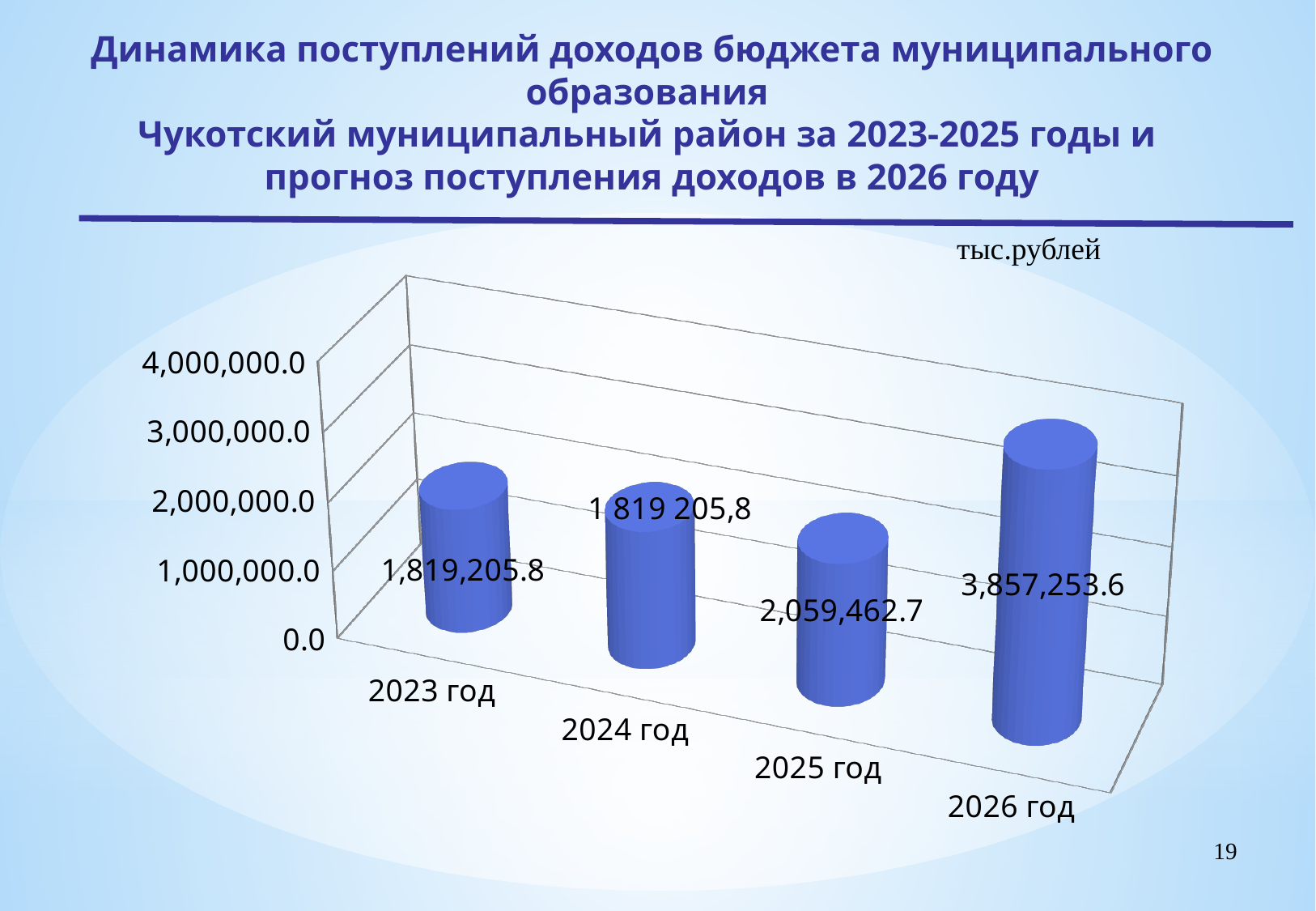
Which is larger, the value for 2025 год or the value for 2023 год? 2025 год Is the value for 2026 год greater or less than 3,000,000.0? greater What is the difference between the values for 2026 год and 2025 год? 1,797,790.9 What is the difference between the values for 2025 год and 2023 год? 240,256.9 What is the value for 2026 год? 3,857,253.6 How many years are shown on the chart? 4 What kind of chart is shown on the slide? bar chart What unit of measurement is indicated above the chart? тыс.рублей Which year has the highest value? 2026 год What is the value for 2025 год? 2,059,462.7 Do the values rise or fall from 2023 год to 2026 год? rise What is the value for 2023 год? 1,819,205.8